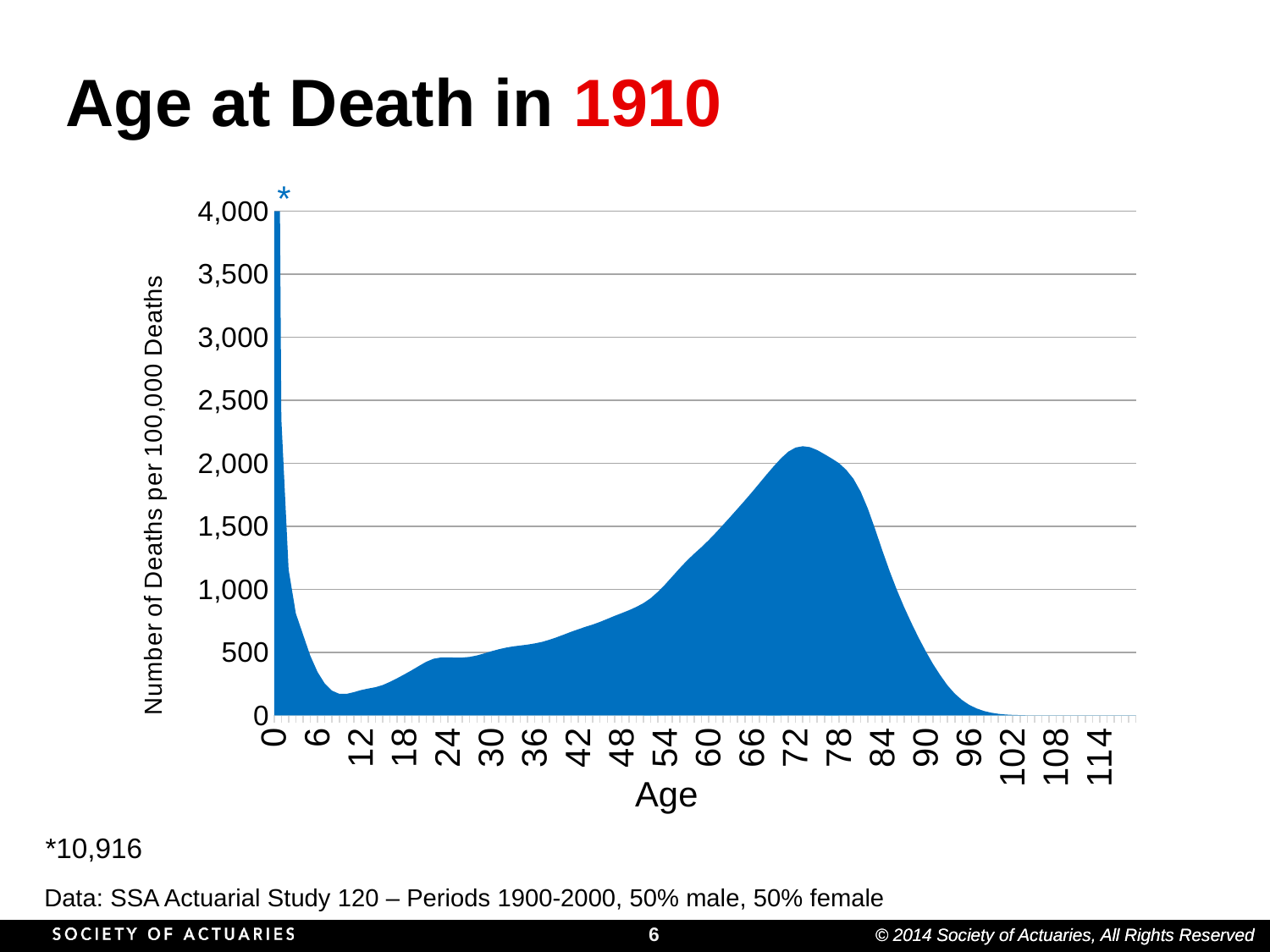
Which age has a higher number of deaths per 100,000 deaths, 24 or 72? 72 Is the value at age 6 greater or less than 500? less Between age 12 and age 72, do the values generally rise or fall? rise Is the value at age 60 greater or less than 1,000? greater Is the value at age 102 greater or less than 500? less Between age 72 and age 102, do the values rise or fall? fall What is the title of the chart? Age at Death in 1910 What is the label of the vertical axis? Number of Deaths per 100,000 Deaths At which age is the number of deaths per 100,000 deaths highest? 0 What is the number of deaths per 100,000 deaths at age 0, as given by the asterisk footnote? 10,916 What kind of chart is shown on the slide? area chart